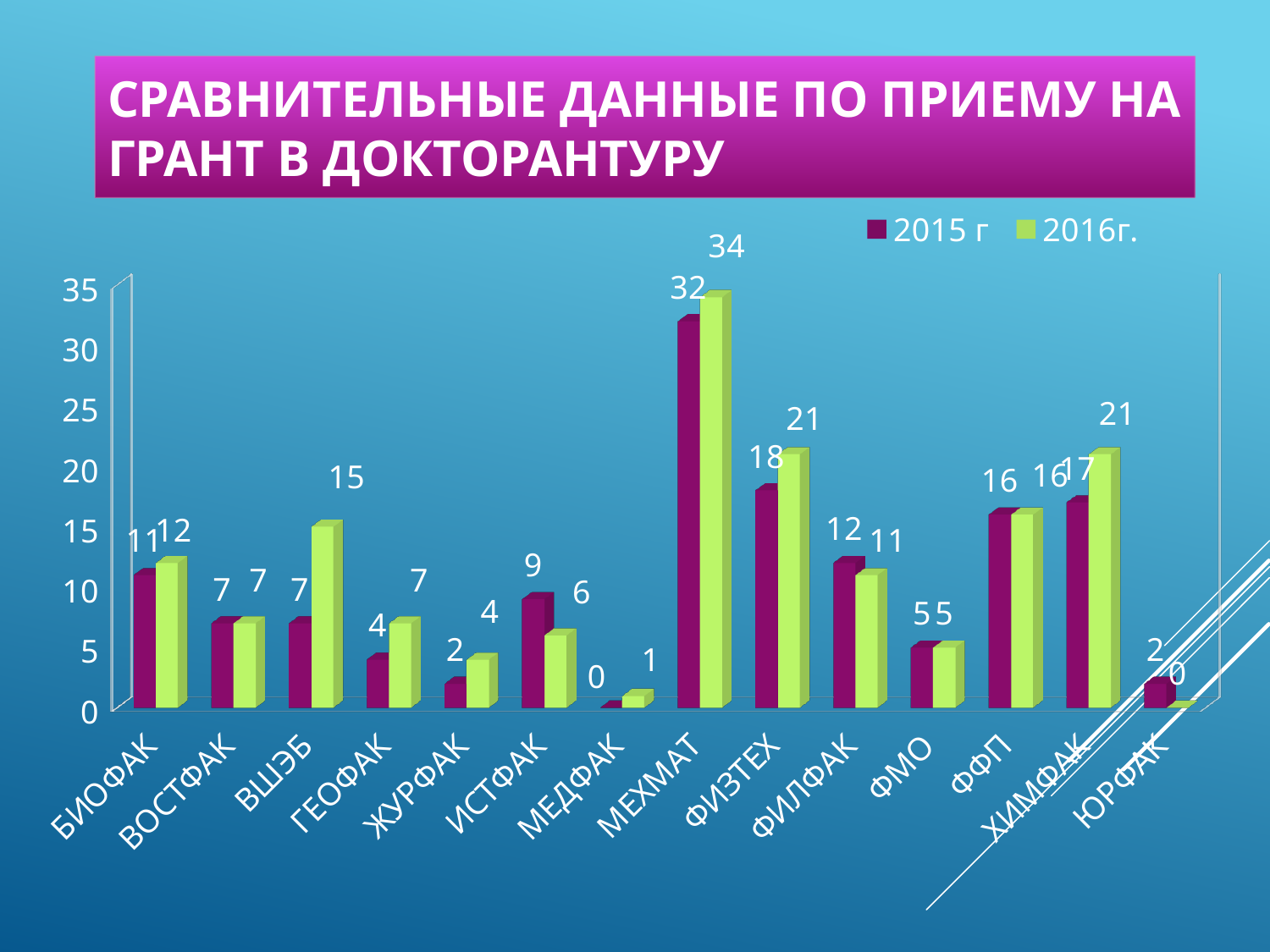
Which is larger for ИСТФАК: the 2015 г value or the 2016г. value? 2015 г What kind of chart is shown on the slide? bar chart How many categories are shown on the x axis? 14 What is the value for ХИМФАК in the 2016г. series? 21 What is the value for ВШЭБ in the 2016г. series? 15 What is the value for МЕХМАТ in the 2015 г series? 32 Which category has the highest value in the 2016г. series? МЕХМАТ How many series does the legend list? 2 What is the difference between the 2016г. and 2015 г values for ВШЭБ? 8 Which category has the lowest value in the 2015 г series? МЕДФАК What are the two series named in the legend? 2015 г and 2016г. Is the 2016г. value for ФИЗТЕХ greater or less than 20? greater